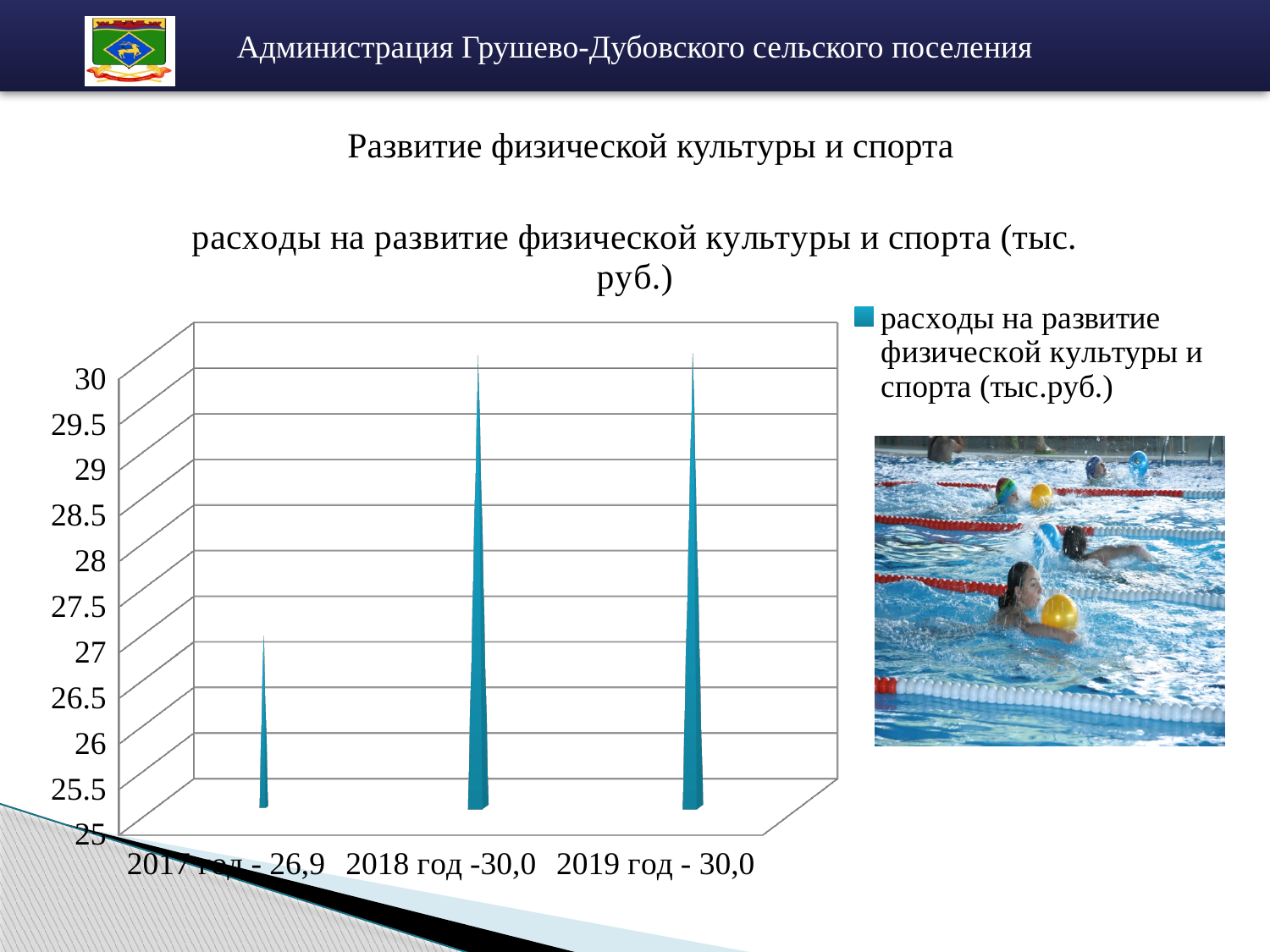
Is the value for 2017 год greater or less than 26? greater What is the value for 2017 год in the chart 'расходы на развитие физической культуры и спорта (тыс. руб.)'? 26,9 What is the title of the chart? расходы на развитие физической культуры и спорта (тыс. руб.) What kind of chart is shown on the slide? bar chart What is the value for 2018 год in the chart? 30,0 Do the values rise or fall from 2017 год to 2018 год? rise Which year has the lowest value in the chart? 2017 год How many categories (years) are shown in the chart? 3 Which is larger, the value for 2017 год or the value for 2019 год? 2019 год What is the value for 2019 год in the chart? 30,0 How many series does the legend list? 1 What is the difference between the values for 2018 год and 2017 год? 3,1